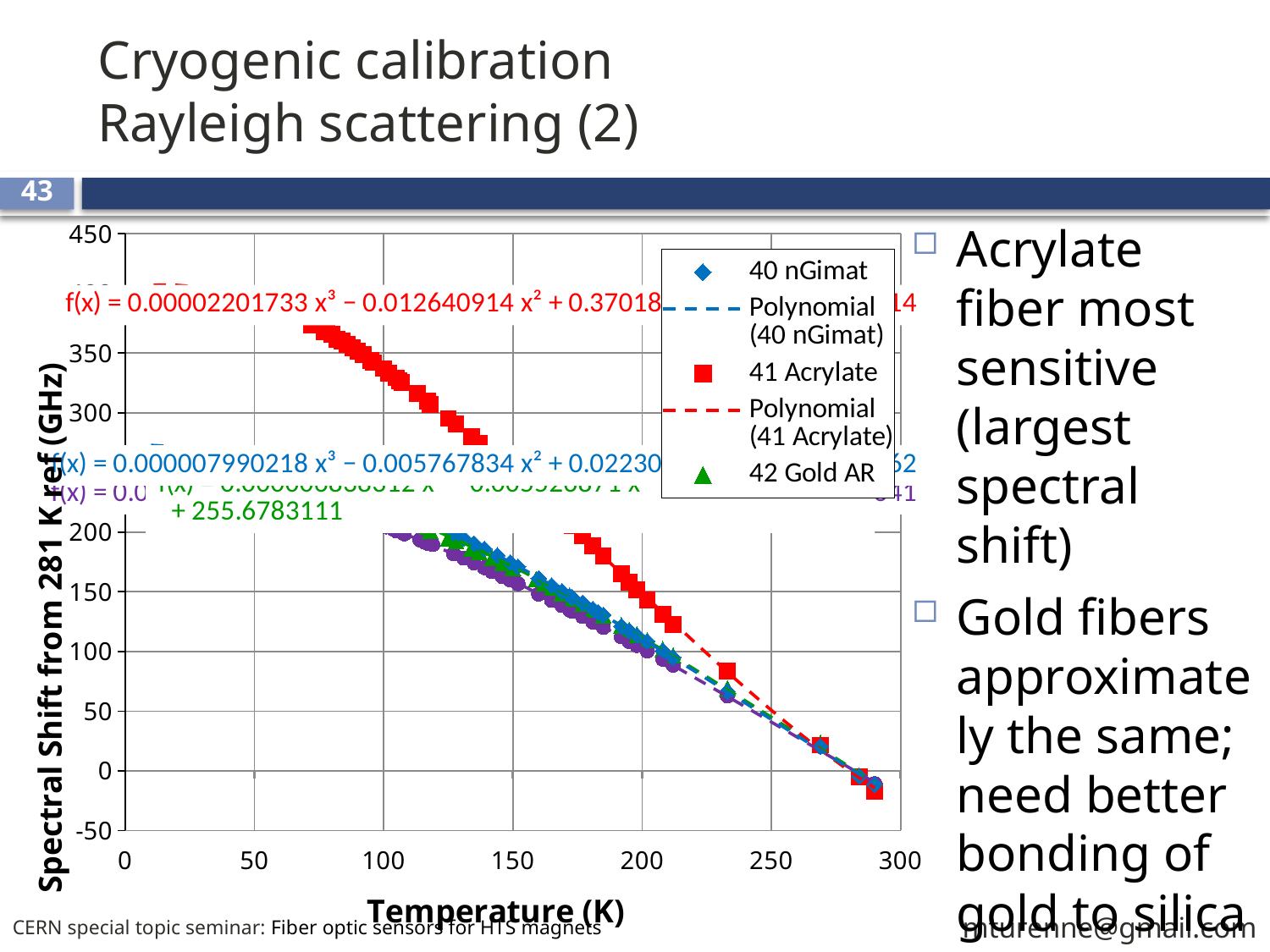
What marker colour is used for the 42 Gold AR series in the legend? green Is the spectral shift for 41 Acrylate at 100 K greater or less than 250? greater Is the spectral shift for 42 Gold AR at 150 K greater or less than 200? less Is the spectral shift for 40 nGimat at 200 K greater or less than 50? greater As temperature increases along the x axis, do the spectral shift values rise or fall? fall At 100 K, which series shows the highest spectral shift? 41 Acrylate What kind of chart is shown on the slide? scatter chart What is the title of the x axis of the chart? Temperature (K) At 100 K, which series has the larger spectral shift, 41 Acrylate or 40 nGimat? 41 Acrylate